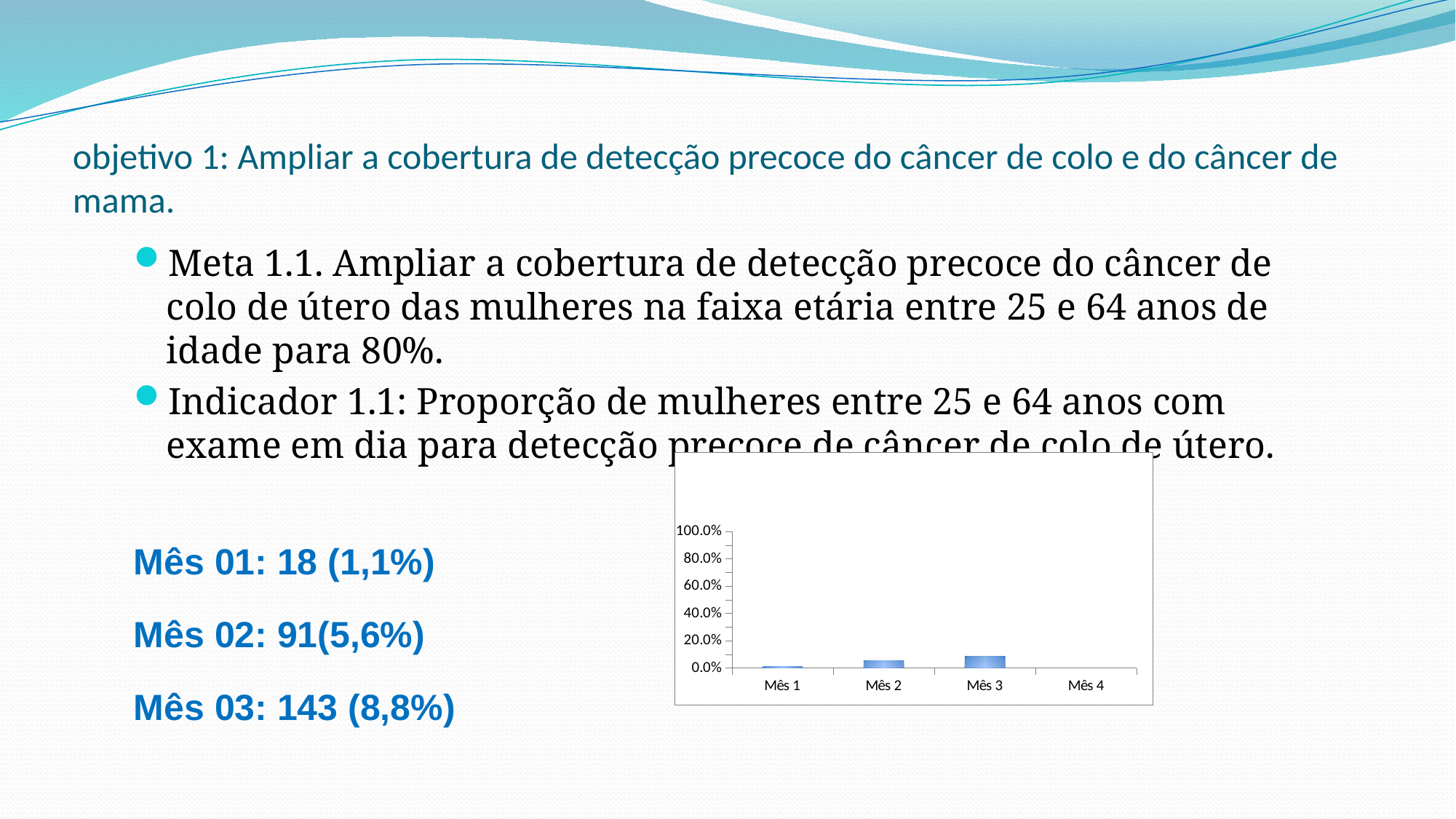
What kind of chart is shown on the slide? bar chart Which is larger in the chart, the bar for Mês 3 or the bar for Mês 2? Mês 3 What is the interval between the tick marks on the chart's y axis? 20.0% Is the value for Mês 3 greater or less than 20.0%? less Which month has the highest bar in the chart? Mês 3 How many categories are shown on the x axis of the chart? 4 Which is larger in the chart, the bar for Mês 2 or the bar for Mês 1? Mês 2 Is the value for Mês 1 greater or less than 20.0%? less What is the highest value shown on the chart's y axis? 100.0% Among Mês 1, Mês 2 and Mês 3, which month has the lowest bar in the chart? Mês 1 Do the bars rise or fall from Mês 1 to Mês 3? rise